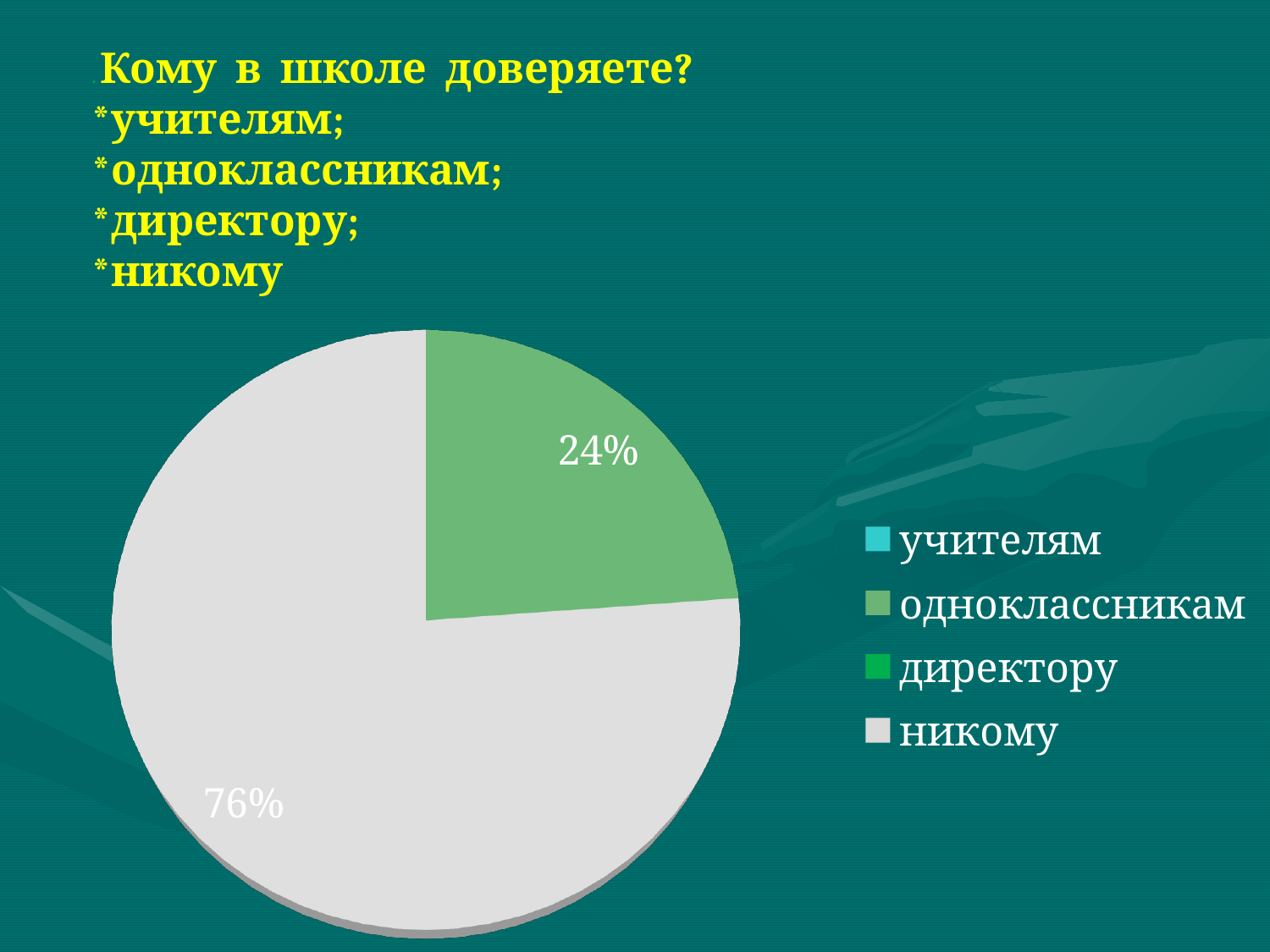
How many slices with printed percentage labels are visible in the pie? 2 Is the share for "никому" greater or less than 50%? greater What kind of chart is shown on the slide? pie chart What colour is the slice for "никому"? grey Which of the two visible slices is larger, "одноклассникам" or "никому"? никому What share of the pie is labelled for "никому"? 76% What is the difference in percentage points between the "никому" slice and the "одноклассникам" slice? 52 Is the share for "одноклассникам" greater or less than 25%? less Which category has the largest slice of the pie? никому What share of the pie is labelled for "одноклассникам"? 24% Which legend entry is shown in light green? одноклассникам How many entries does the legend list? 4